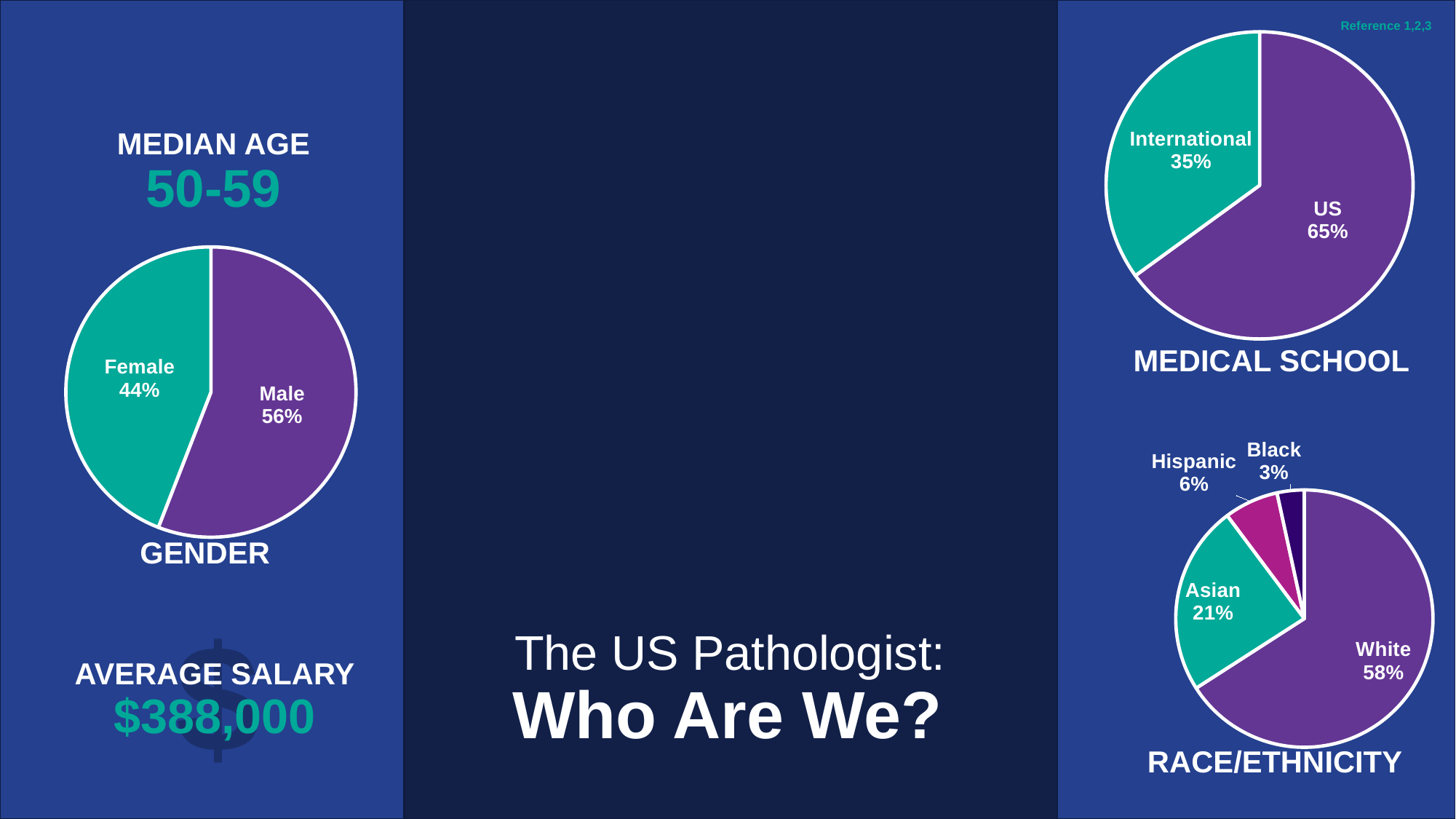
In the MEDICAL SCHOOL pie chart, how many slices are there? 2 In the RACE/ETHNICITY pie chart, how many categories are shown? 4 In the RACE/ETHNICITY pie chart, what is the difference between the White and Asian shares? 37% In the RACE/ETHNICITY pie chart, what colour is the Hispanic slice? Magenta In the GENDER pie chart, what is the difference between the Male and Female shares? 12% In the MEDICAL SCHOOL pie chart, what percentage is International? 35% In the RACE/ETHNICITY pie chart, what percentage is Asian? 21% In the GENDER pie chart, what percentage is Female? 44% What kind of chart is used for RACE/ETHNICITY? Pie chart In the GENDER pie chart, which slice is larger, Male or Female? Male In the MEDICAL SCHOOL pie chart, which category has the largest share? US In the RACE/ETHNICITY pie chart, which category has the smallest share? Black